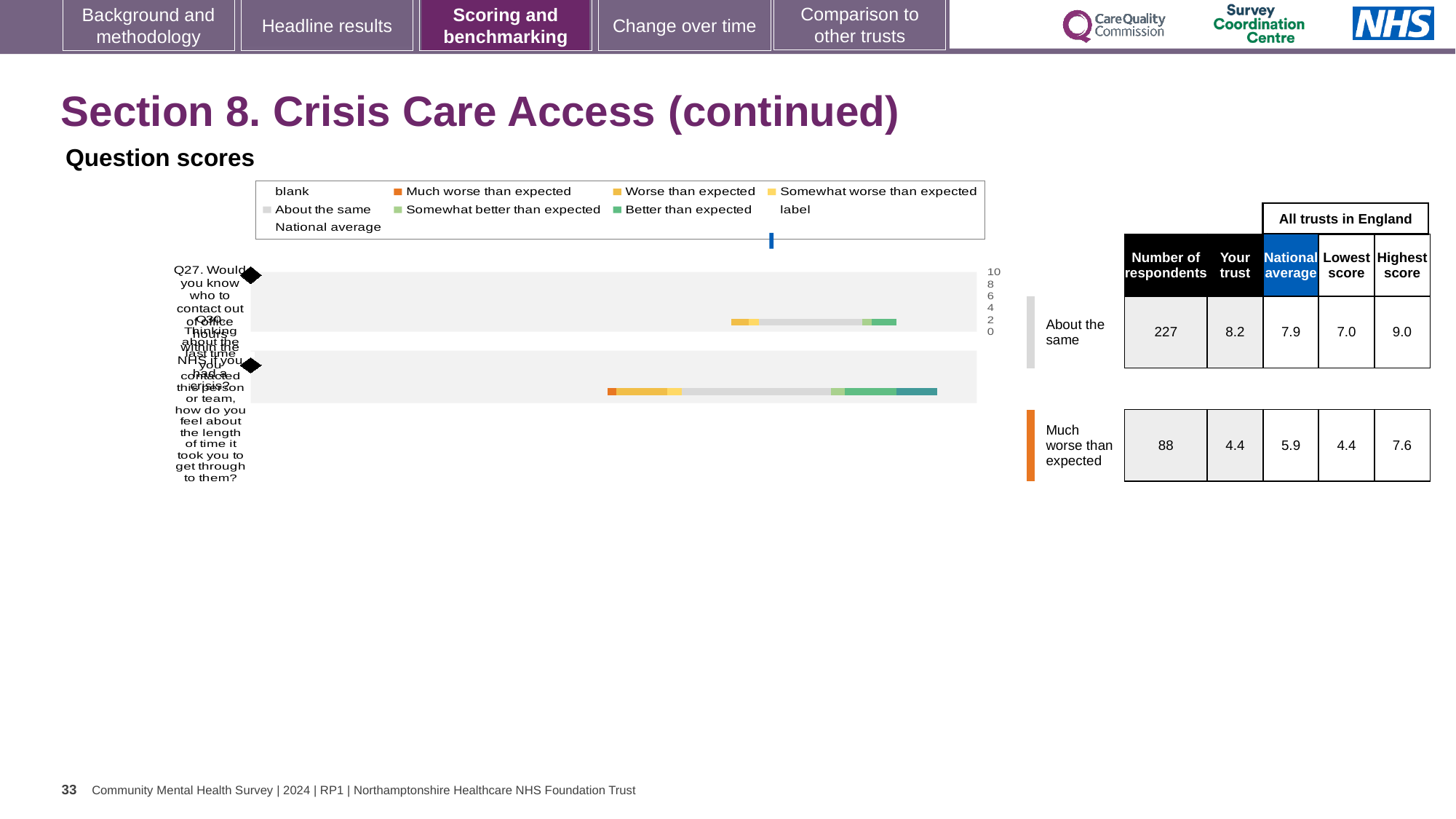
What kind of chart is shown under 'Question scores'? bar chart What is the highest score across all trusts in England for the second question row (Q30)? 7.6 What is the 'Your trust' score for the second question row (Q30)? 4.4 What colour does the legend use for 'Much worse than expected'? orange What is the difference between the highest and lowest scores for the first question row (Q27)? 2.0 How many questions (rows) are plotted in the Question scores chart? 2 What is the difference between the national average and the trust's score for the second question row (Q30)? 1.5 How many respondents answered the second question row (Q30)? 88 What is the 'Your trust' score for the first question row (Q27) in the Question scores chart? 8.2 For the first question row (Q27), which is larger: the trust's score or the national average? the trust's score What is the national average for the first question row (Q27)? 7.9 Which benchmark category is the second question row (Q30) assigned to? Much worse than expected